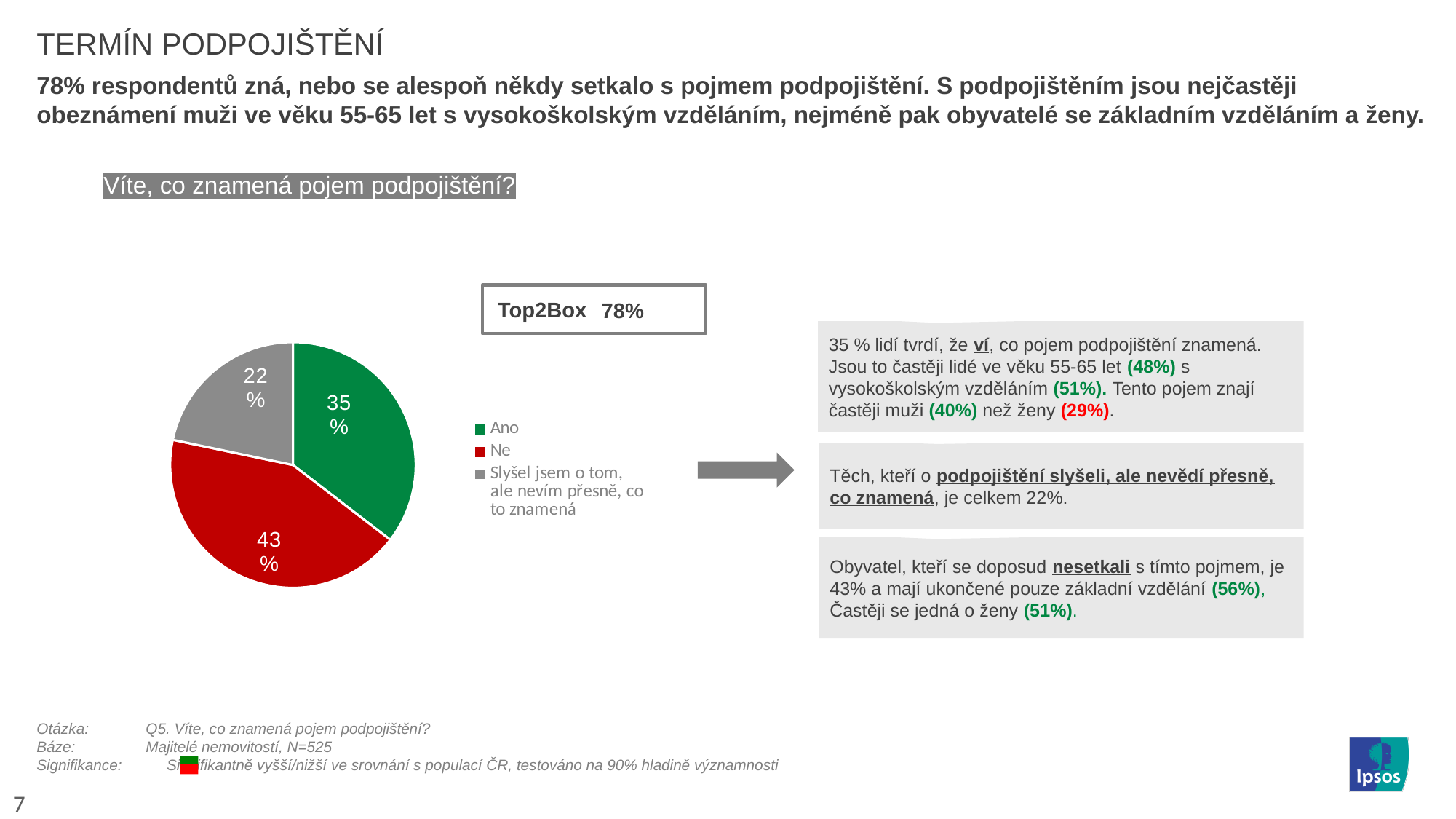
How many slices does the pie chart have? 3 Which category has the largest slice of the pie? Ne What colour is the "Ne" slice in the pie chart? red How many entries does the legend of the pie chart list? 3 Which category has the smallest slice of the pie? Slyšel jsem o tom, ale nevím přesně, co to znamená Which is larger, the "Ano" slice or the "Ne" slice? Ne What share of the pie does the "Slyšel jsem o tom, ale nevím přesně, co to znamená" slice represent? 22% What share of the pie does the "Ano" slice represent? 35% What kind of chart is shown on the slide? pie chart What is the difference in percentage points between the "Ano" slice and the "Slyšel jsem o tom, ale nevím přesně, co to znamená" slice? 13 What share of the pie does the "Ne" slice represent? 43% What is the difference in percentage points between the "Ne" slice and the "Ano" slice? 8